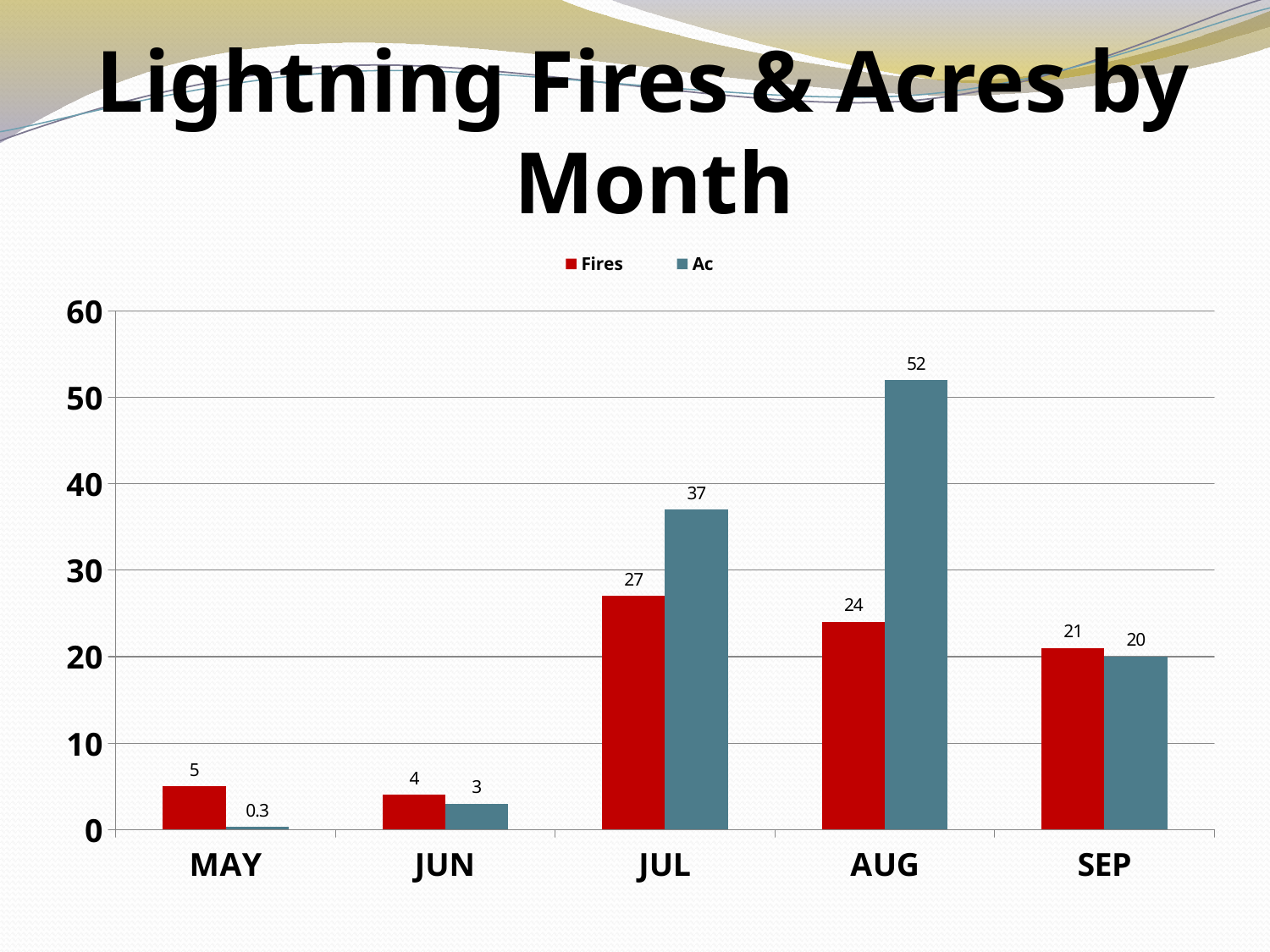
What is the value for Fires in JUL? 27 How many months are shown on the x axis? 5 Which month has the highest value for Fires? JUL What is the value for Ac in AUG? 52 What is the title of the chart? Lightning Fires & Acres by Month What is the value for Ac in MAY? 0.3 What kind of chart is shown on the slide? bar chart What is the difference between the Ac value and the Fires value in AUG? 28 Which is larger in SEP, Fires or Ac? Fires Is the value for Ac in JUL greater or less than 30? greater How many series does the legend list? 2 Which month has the lowest value for Ac? MAY